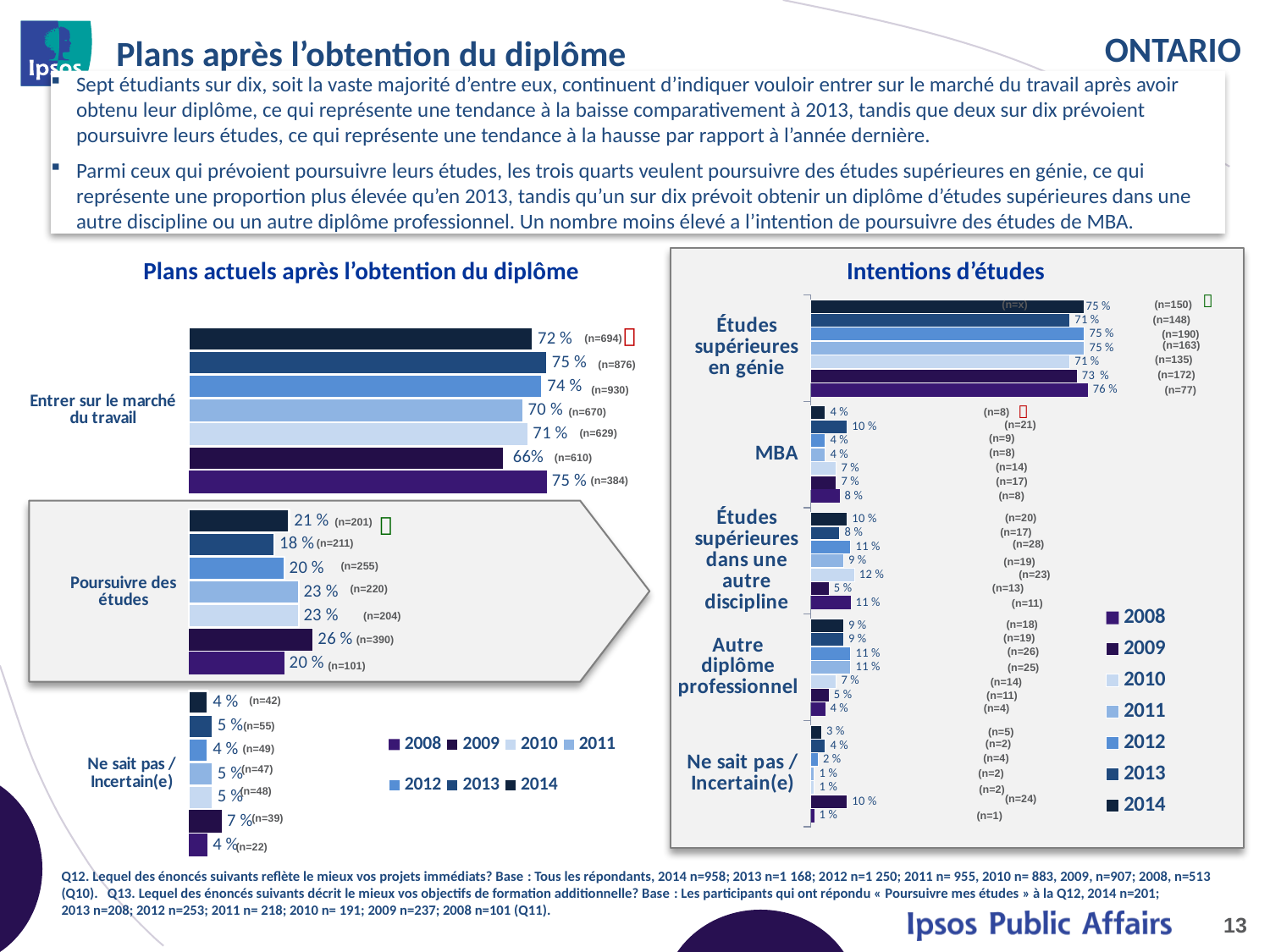
In the 'Intentions d'études' chart, what is the 2014 value for 'Études supérieures en génie'? 75 % In the 'Plans actuels après l'obtention du diplôme' chart, what is the 2009 value for 'Poursuivre des études'? 26 % How many categories are shown in the 'Intentions d'études' chart? 5 In the 'Plans actuels après l'obtention du diplôme' chart, which year has the lowest value for 'Entrer sur le marché du travail'? 2009 In the 'Plans actuels après l'obtention du diplôme' chart, what is the 2014 value for 'Entrer sur le marché du travail'? 72 % What kind of chart is 'Intentions d'études'? Bar chart In the 'Intentions d'études' chart, which category has the highest values across all years? Études supérieures en génie In the 'Plans actuels après l'obtention du diplôme' chart, what is the difference between the 2013 and 2014 values for 'Entrer sur le marché du travail'? 3 % In the 'Plans actuels après l'obtention du diplôme' chart, what is the 2014 value for 'Ne sait pas / Incertain(e)'? 4 % In the 'Plans actuels après l'obtention du diplôme' chart, which is larger for 'Poursuivre des études': the 2014 value or the 2013 value? 2014 In the 'Intentions d'études' chart, what is the 2013 value for 'MBA'? 10 % How many series does the legend of the 'Plans actuels après l'obtention du diplôme' chart list? 7